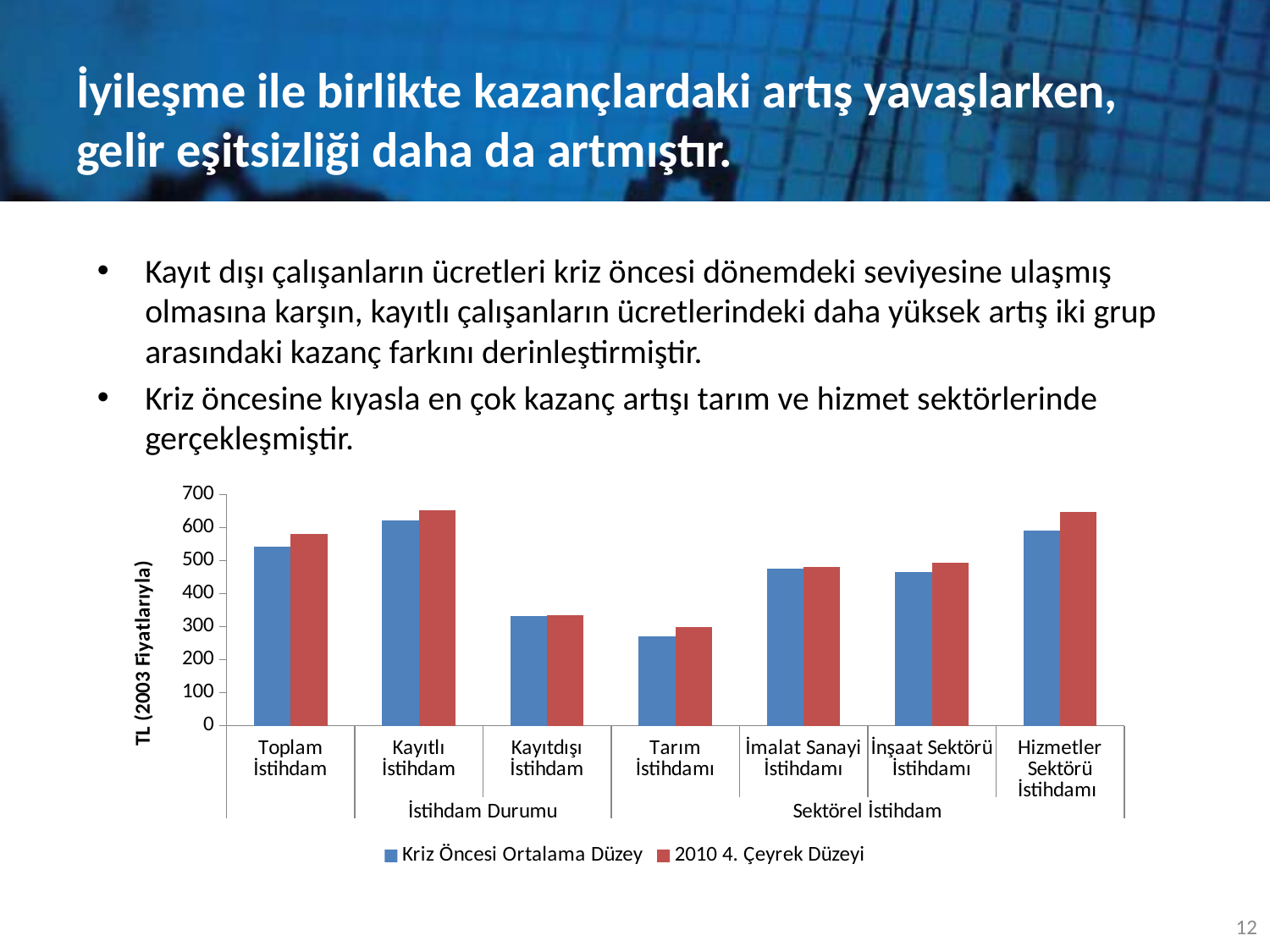
Which is larger: the Kriz Öncesi Ortalama Düzey value for Kayıtlı İstihdam or for Kayıtdışı İstihdam? Kayıtlı İstihdam Which category has the lowest Kriz Öncesi Ortalama Düzey value? Tarım İstihdamı Is the 2010 4. Çeyrek Düzeyi value for Hizmetler Sektörü İstihdamı greater or less than 600? greater Is the Kriz Öncesi Ortalama Düzey value for Toplam İstihdam greater or less than 500? greater Which category has the lowest 2010 4. Çeyrek Düzeyi value? Tarım İstihdamı Is the 2010 4. Çeyrek Düzeyi value for Kayıtdışı İstihdam greater or less than 400? less How many employment categories are shown along the x axis of the chart? 7 What kind of chart is shown on the slide? bar chart Which category has the highest Kriz Öncesi Ortalama Düzey value? Kayıtlı İstihdam What is the label of the vertical axis of the chart? TL (2003 Fiyatlarıyla) How many series does the chart legend list? 2